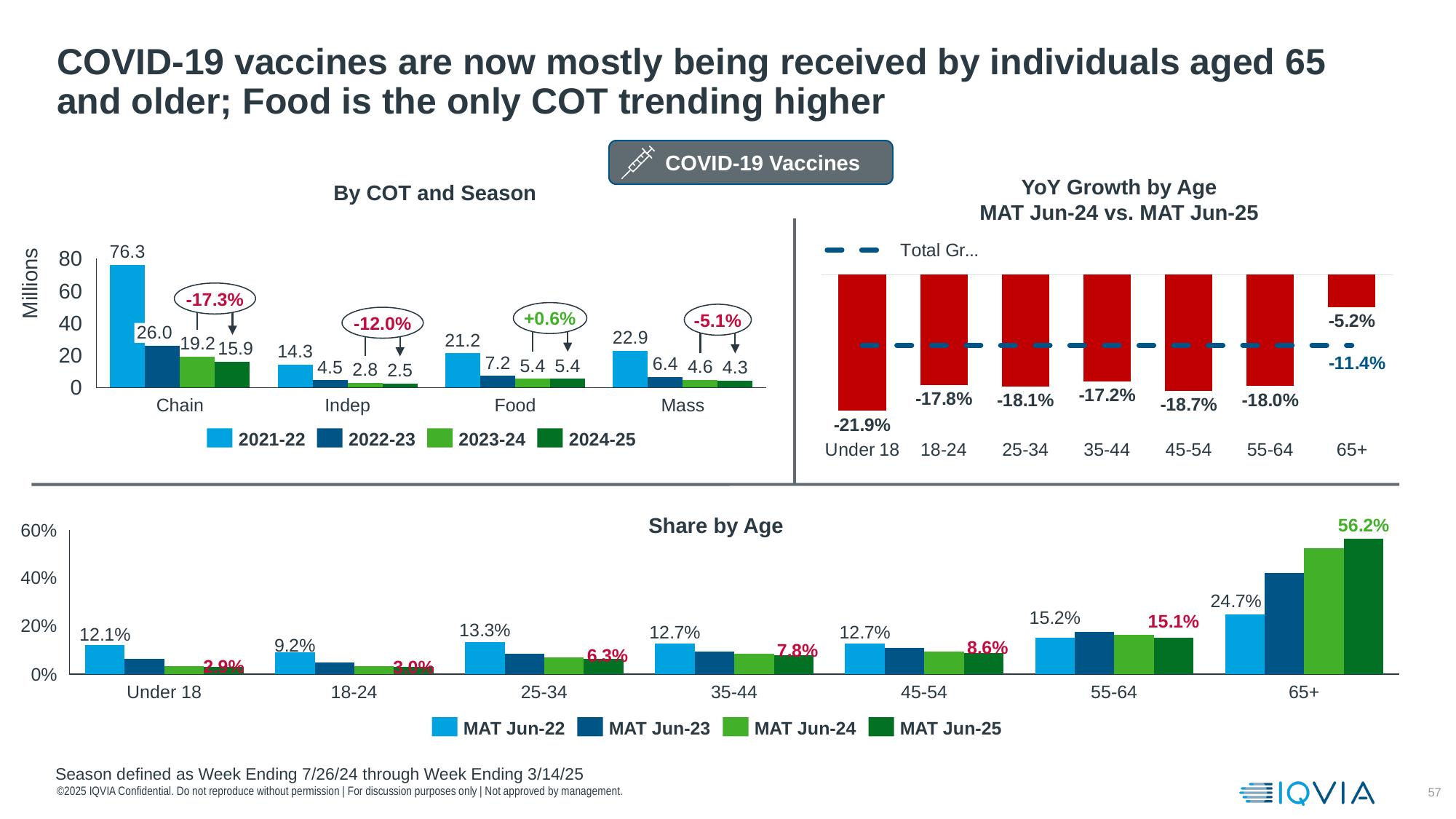
In the 'YoY Growth by Age' chart, which age group has the largest decline? Under 18 In the 'By COT and Season' chart, what is the value for Chain in the 2021-22 season? 76.3 In the 'By COT and Season' chart, how many seasons does the legend list? 4 In the 'Share by Age' chart, what is the MAT Jun-25 share for the 65+ age group? 56.2% In the 'YoY Growth by Age' chart, which age group has the smallest decline? 65+ In the 'Share by Age' chart, what is the difference between the MAT Jun-22 and MAT Jun-25 shares for Under 18? 9.2% In the 'By COT and Season' chart, what is the value for Food in the 2024-25 season? 5.4 In the 'By COT and Season' chart, what is the difference between the 2021-22 and 2022-23 values for Mass? 16.5 In the 'YoY Growth by Age' chart, what is the total growth value shown by the dashed line? -11.4% In the 'Share by Age' chart, is the MAT Jun-24 share for 65+ greater or less than 40%? greater In the 'YoY Growth by Age' chart, what is the growth for the 45-54 age group? -18.7% In the 'By COT and Season' chart, which COT has the highest 2024-25 value? Chain